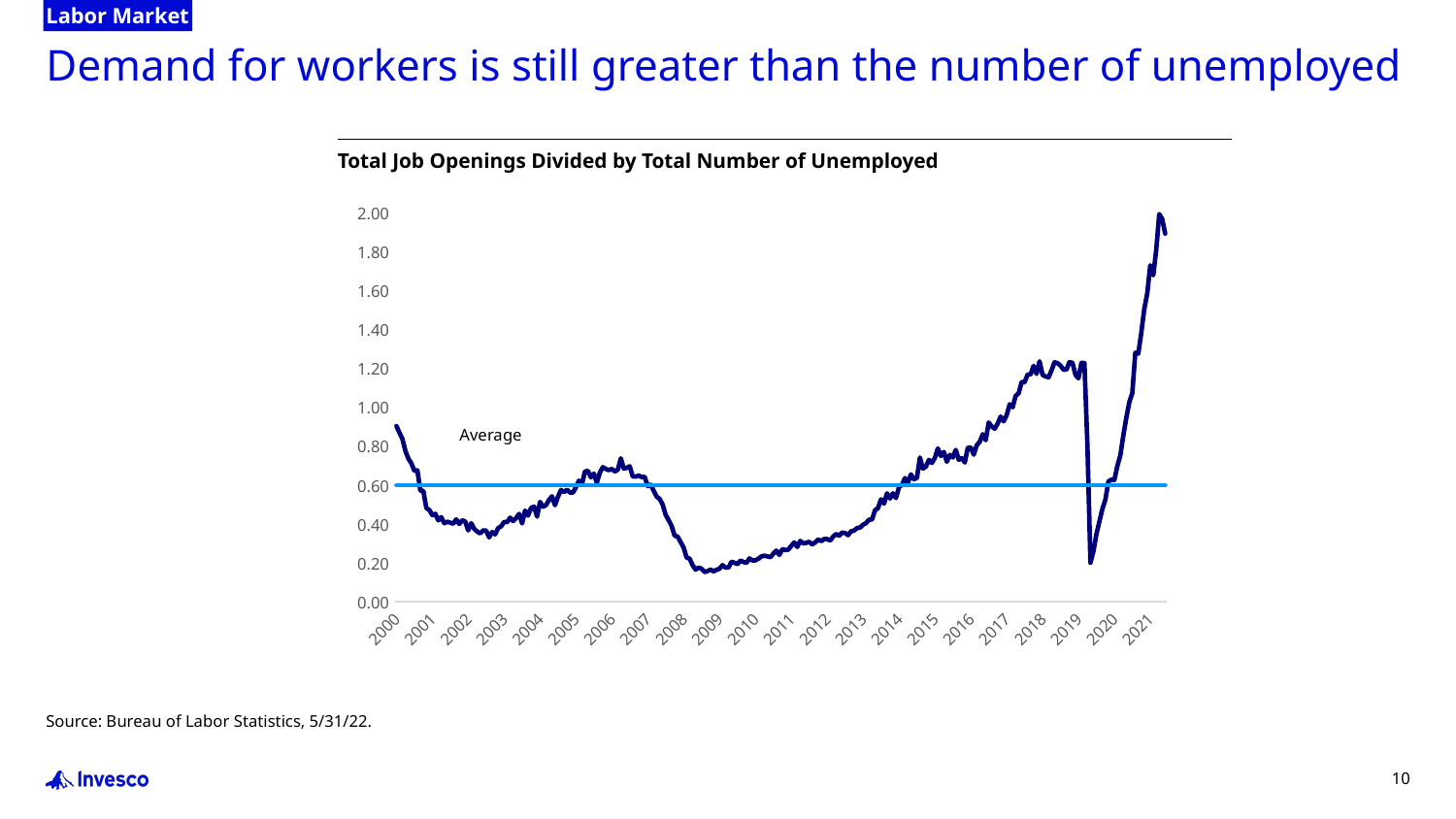
Does the ratio generally rise or fall between 2000 and 2003? fall How many year labels are shown on the x axis? 22 Is the lowest value of the ratio in 2020 greater or less than 0.40? less Is the value of the ratio in 2009 greater or less than 0.40? less Is the value of the ratio in 2003 greater or less than 0.60? less What label is shown next to the horizontal light-blue line on the chart? Average Does the ratio generally rise or fall between 2009 and 2018? rise What kind of chart is shown on the slide? line chart What is the title of the chart? Total Job Openings Divided by Total Number of Unemployed